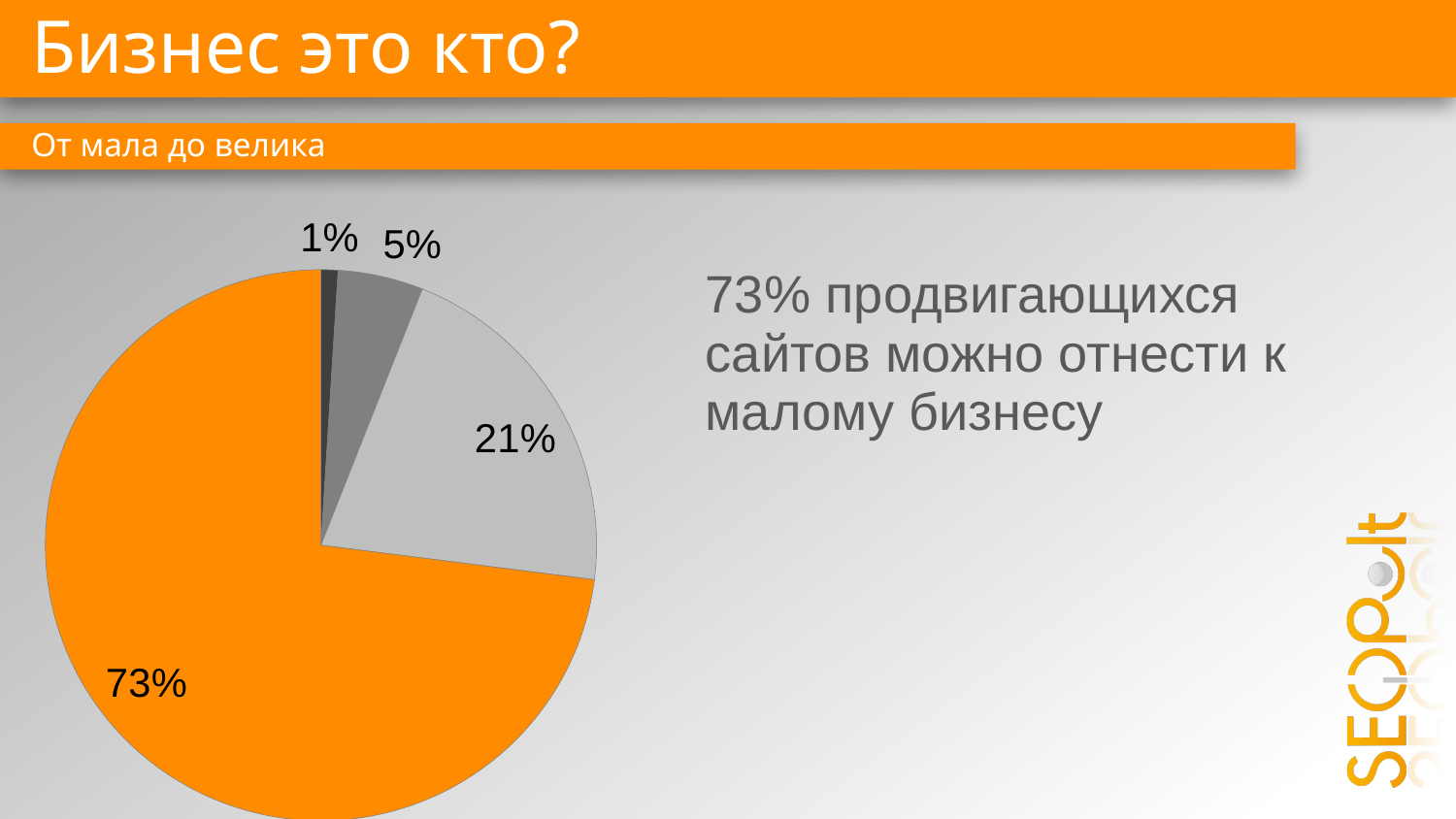
What colour is the largest slice of the pie chart? orange Is the light grey slice greater or less than 25% of the pie? less Which slice is larger: the orange slice or the light grey slice? the orange slice What kind of chart is shown on the slide? pie chart According to the slide text, what percentage of promoted sites can be attributed to small business? 73% What is the difference between the largest slice (73%) and the second-largest slice (21%)? 52 percentage points What value is shown on the orange slice of the pie chart? 73% What is the value of the smallest slice of the pie chart? 1% How many slices does the pie chart have? 4 What share of the pie do the three grey slices (21%, 5% and 1%) make up together? 27% What is the value of the largest slice of the pie chart? 73% What value is shown on the light grey slice of the pie chart? 21%